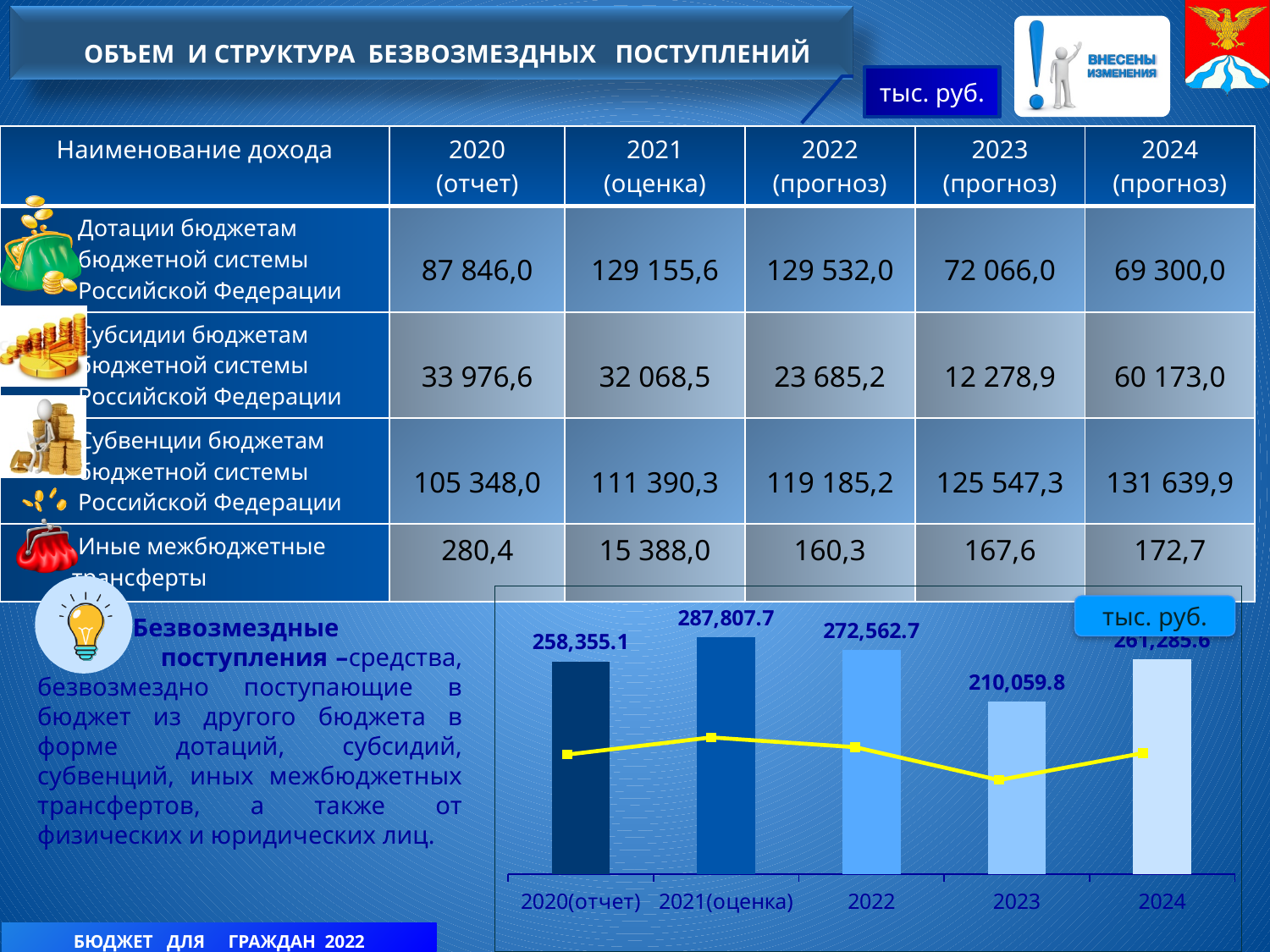
In the bar chart, what is the difference between the values for 2022 and 2023? 62,502.9 How many years (categories) are shown on the x axis of the bar chart? 5 In the bar chart, what is the value for 2023? 210,059.8 In the bar chart, what is the value for 2021(оценка)? 287,807.7 In the bar chart, do the values rise or fall from 2021(оценка) to 2023? fall In the bar chart, what is the value for 2022? 272,562.7 What kind of chart is shown at the bottom right of the slide? bar chart In the bar chart, what is the difference between the values for 2021(оценка) and 2020(отчет)? 29,452.6 In the bar chart, which is larger: the value for 2020(отчет) or the value for 2022? 2022 In the bar chart, which year has the highest value? 2021(оценка) In the bar chart, which year has the lowest value? 2023 In the bar chart, what is the value for 2020(отчет)? 258,355.1